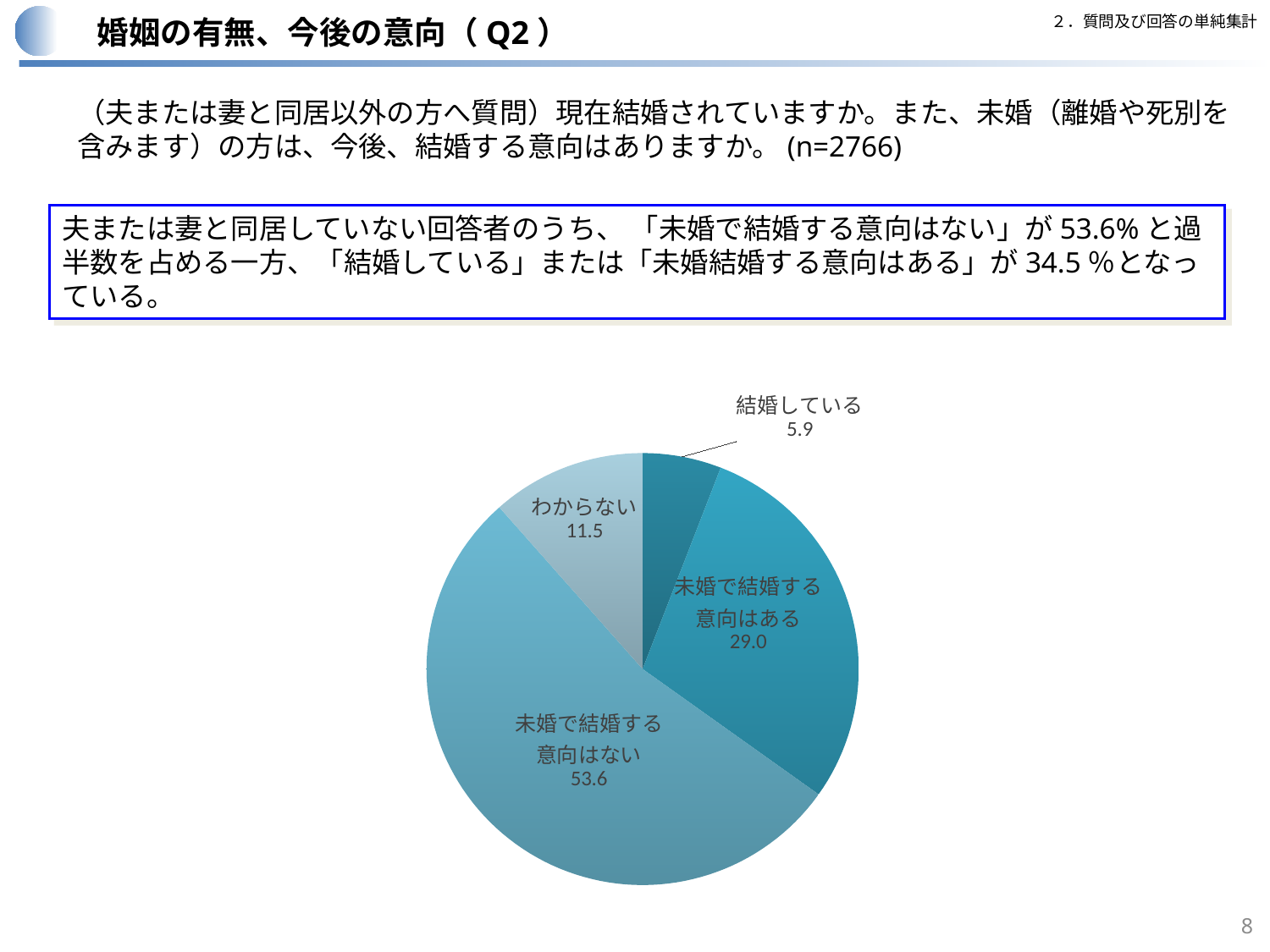
What is the combined value of 結婚している and 未婚で結婚する意向はある? 34.9 How many slices does the pie chart have? 4 What is the value for 未婚で結婚する意向はある? 29.0 What is the difference between the values for 未婚で結婚する意向はない and 未婚で結婚する意向はある? 24.6 What is the sample size (n) stated in the question text above the chart? 2766 What is the value for 結婚している? 5.9 Which is larger, the value for わからない or the value for 結婚している? わからない Which category has the smallest slice? 結婚している Which category has the largest slice? 未婚で結婚する意向はない What kind of chart is shown on the slide? pie chart What is the value for 未婚で結婚する意向はない? 53.6 What is the value for わからない? 11.5